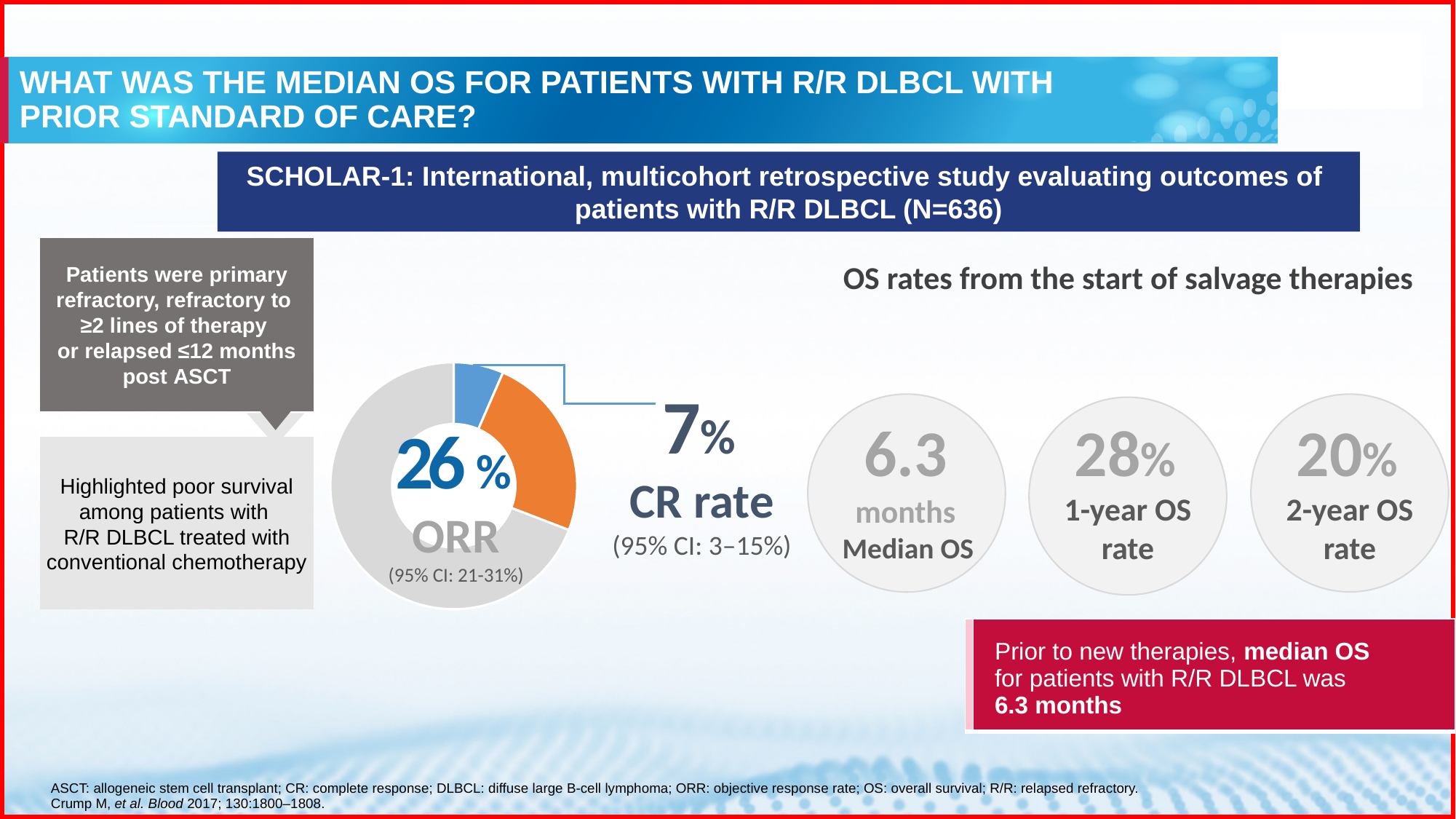
What is the ORR shown in the centre of the donut chart? 26% What is the 95% CI shown for the ORR in the donut chart? 21-31% How many coloured slices does the donut chart have? 3 What is the 95% CI shown for the CR rate? 3–15% What colour is the slice of the donut chart that represents the CR rate? blue In the OS rates circles, what is the median OS? 6.3 months In the OS rates circles, what is the 1-year OS rate? 28% Which is larger, the ORR or the CR rate? ORR What kind of chart is used to show the ORR on the slide? donut chart What is the CR rate indicated by the blue slice of the donut chart? 7% What is the difference between the ORR (26%) and the CR rate (7%)? 19% What share of the donut chart does the CR rate slice represent? 7%